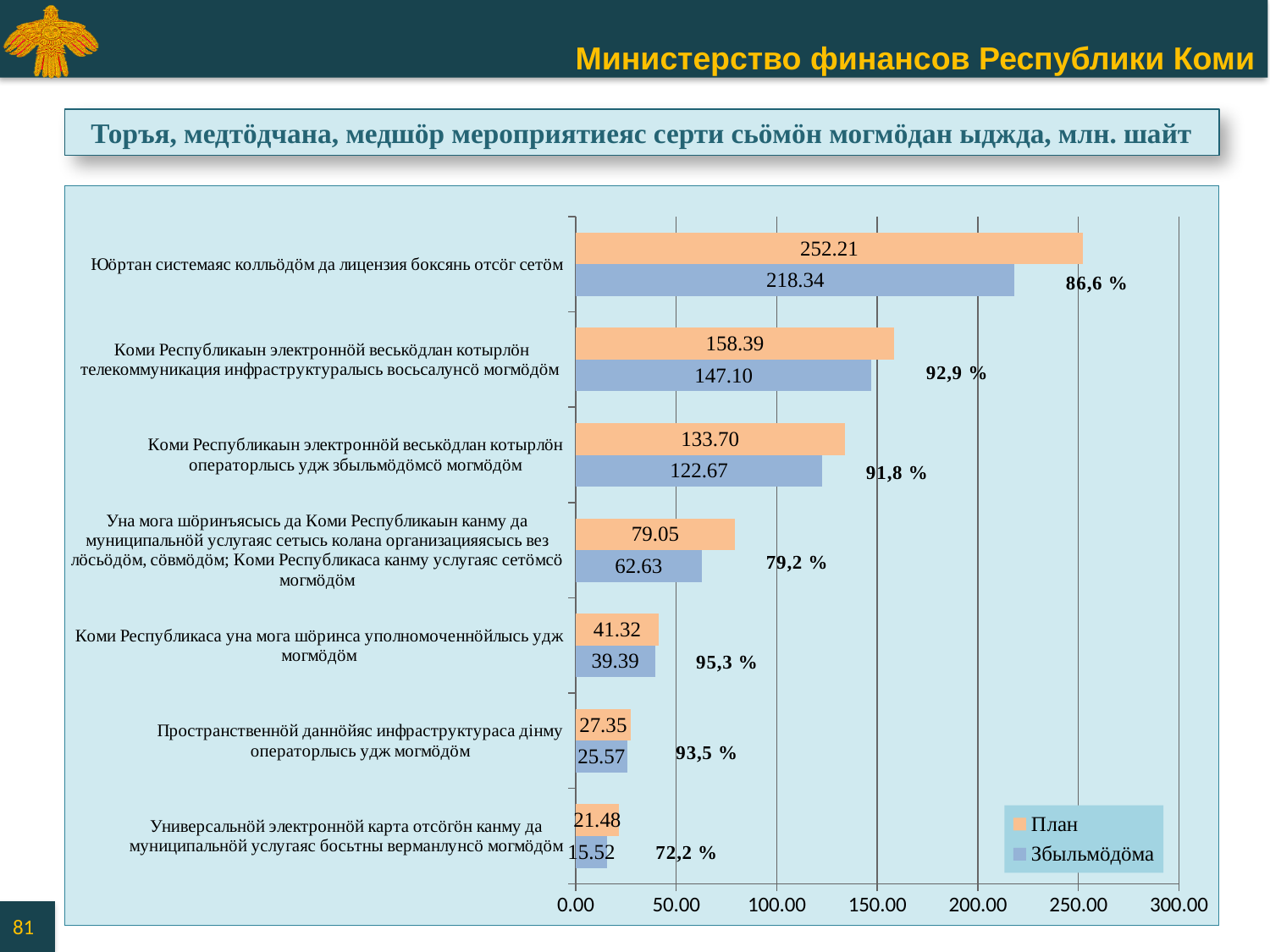
What is the Збыльмӧдӧма value for "Коми Республикаын электроннӧй веськӧдлан котырлӧн телекоммуникация инфраструктуралысь восьсалунсӧ могмӧдӧм"? 147.10 What is the Збыльмӧдӧма value for "Пространственнӧй даннӧйяс инфраструктураса дінму операторлысь удж могмӧдӧм"? 25.57 What is the difference between the План and Збыльмӧдӧма values for "Юӧртан системаяс кольлӧдӧм да лицензия боксянь отсӧг сетӧм"? 33.87 Which category has the highest План value? Юӧртан системаяс кольлӧдӧм да лицензия боксянь отсӧг сетӧм What is the План value for "Юӧртан системаяс кольлӧдӧм да лицензия боксянь отсӧг сетӧм"? 252.21 Is the План value for "Коми Республикаын электроннӧй веськӧдлан котырлӧн операторлысь удж збыльмӧдӧмсӧ могмӧдӧм" greater or less than 150.00? less How many categories are shown in the chart? 7 How many series does the legend list? 2 Which is larger: the План value for "Коми Республикаса уна мога шӧринса уполномоченнӧйлысь удж могмӧдӧм" or the Збыльмӧдӧма value for "Уна мога шӧринъясысь да Коми Республикаын канму да муниципальнӧй услугаяс сетысь колана организацияясысь вез лӧсьӧдӧм, сӧвмӧдӧм; Коми Республикаса канму услугаяс сетӧмсӧ могмӧдӧм"? The Збыльмӧдӧма value for "Уна мога шӧринъясысь..." (62.63) What is the difference between the План and Збыльмӧдӧма values for "Коми Республикаын электроннӧй веськӧдлан котырлӧн телекоммуникация инфраструктуралысь восьсалунсӧ могмӧдӧм"? 11.29 What kind of chart is shown on the slide? Bar chart Which category has the lowest Збыльмӧдӧма value? Универсальнӧй электроннӧй карта отсӧгӧн канму да муниципальнӧй услугаяс босьтны верманлунсӧ могмӧдӧм